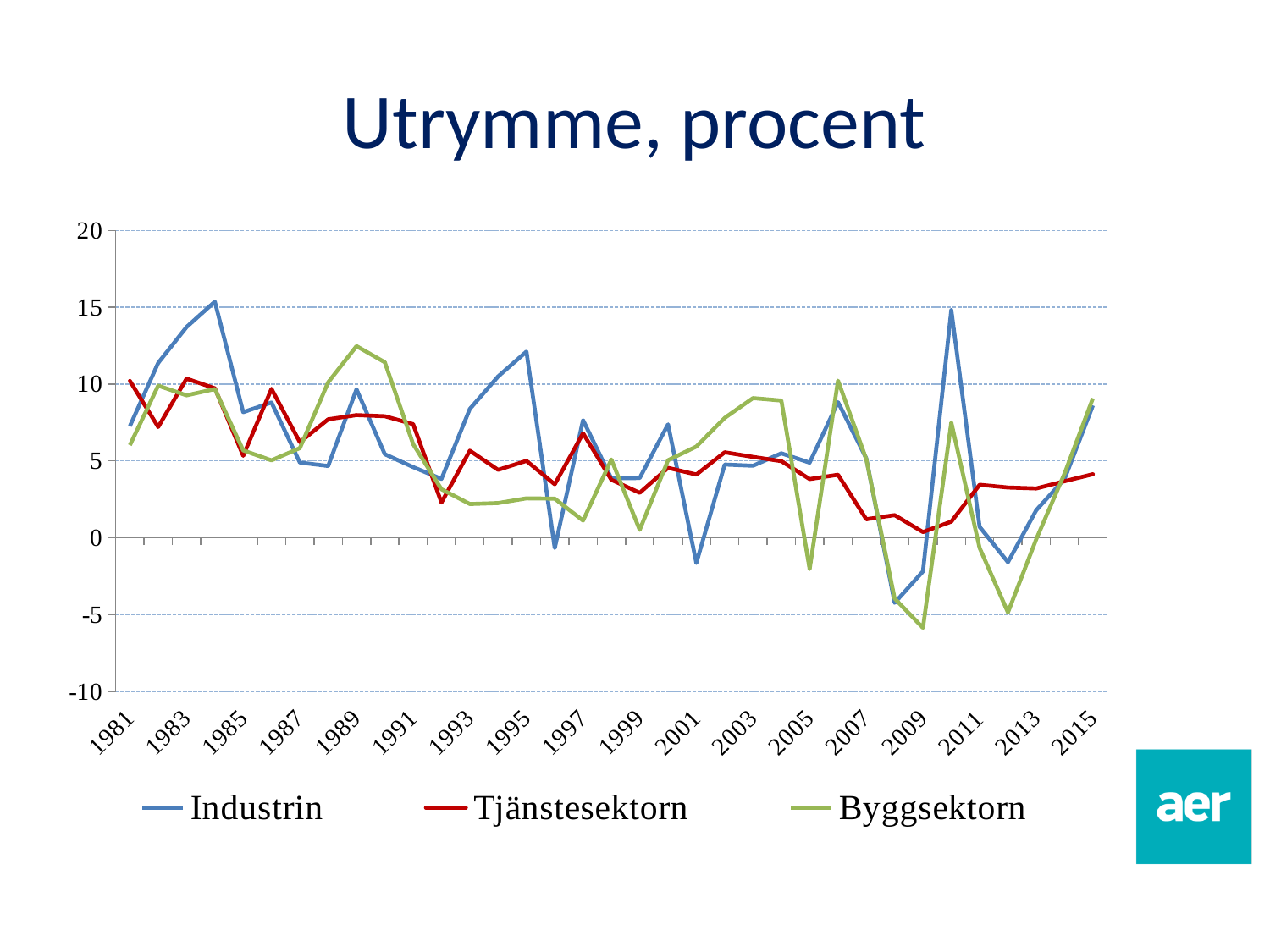
Does the Tjänstesektorn series overall rise or fall from 1981 to 2015? fall What is the title of the chart? Utrymme, procent How many series does the legend list? 3 In 1989, which is larger: Byggsektorn or Industrin? Byggsektorn Is the value for Byggsektorn in 1989 greater or less than 10? greater What kind of chart is shown on the slide? Line chart Is the value for Industrin in 2010 greater or less than 10? greater Is the value for Byggsektorn in 2009 greater or less than 0? less Which series is drawn in red? Tjänstesektorn How many years are labelled on the x axis? 18 Which series reaches the highest value anywhere on the chart? Industrin Which series reaches the lowest value anywhere on the chart? Byggsektorn